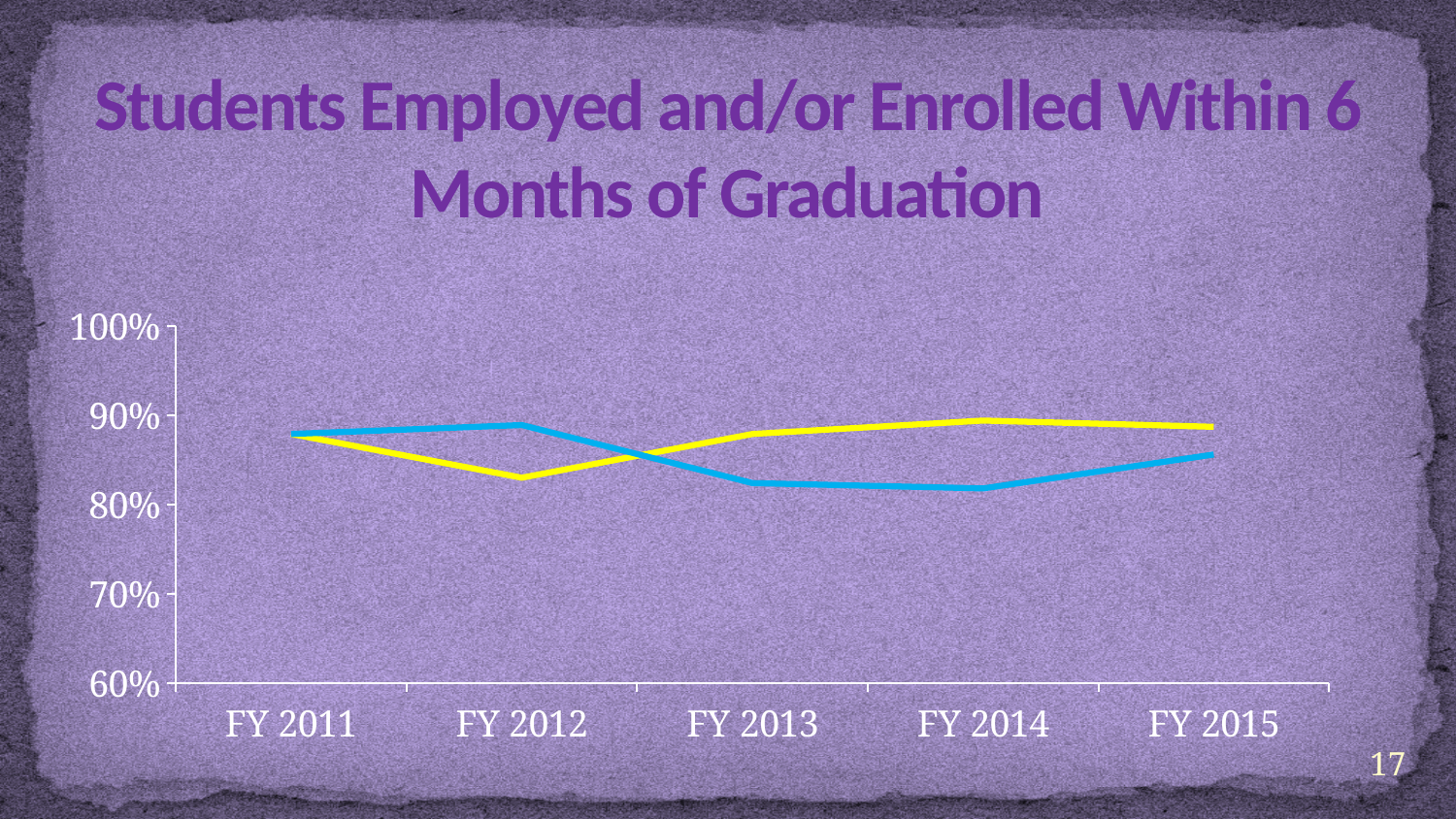
In which fiscal year does the yellow line reach its lowest value? FY 2012 How many lines are plotted on the chart? 2 What is the title of the chart? Students Employed and/or Enrolled Within 6 Months of Graduation Is the value of the yellow line at FY 2012 greater or less than 80%? greater How many fiscal years are shown on the x axis? 5 Is the value of the yellow line at FY 2012 greater or less than 90%? less Is the value of the blue line at FY 2014 greater or less than 90%? less What kind of chart is shown on the slide? line chart Does the blue line rise or fall from FY 2012 to FY 2014? fall At FY 2012, which line has the higher value, the yellow line or the blue line? blue line At FY 2014, which line has the higher value, the yellow line or the blue line? yellow line